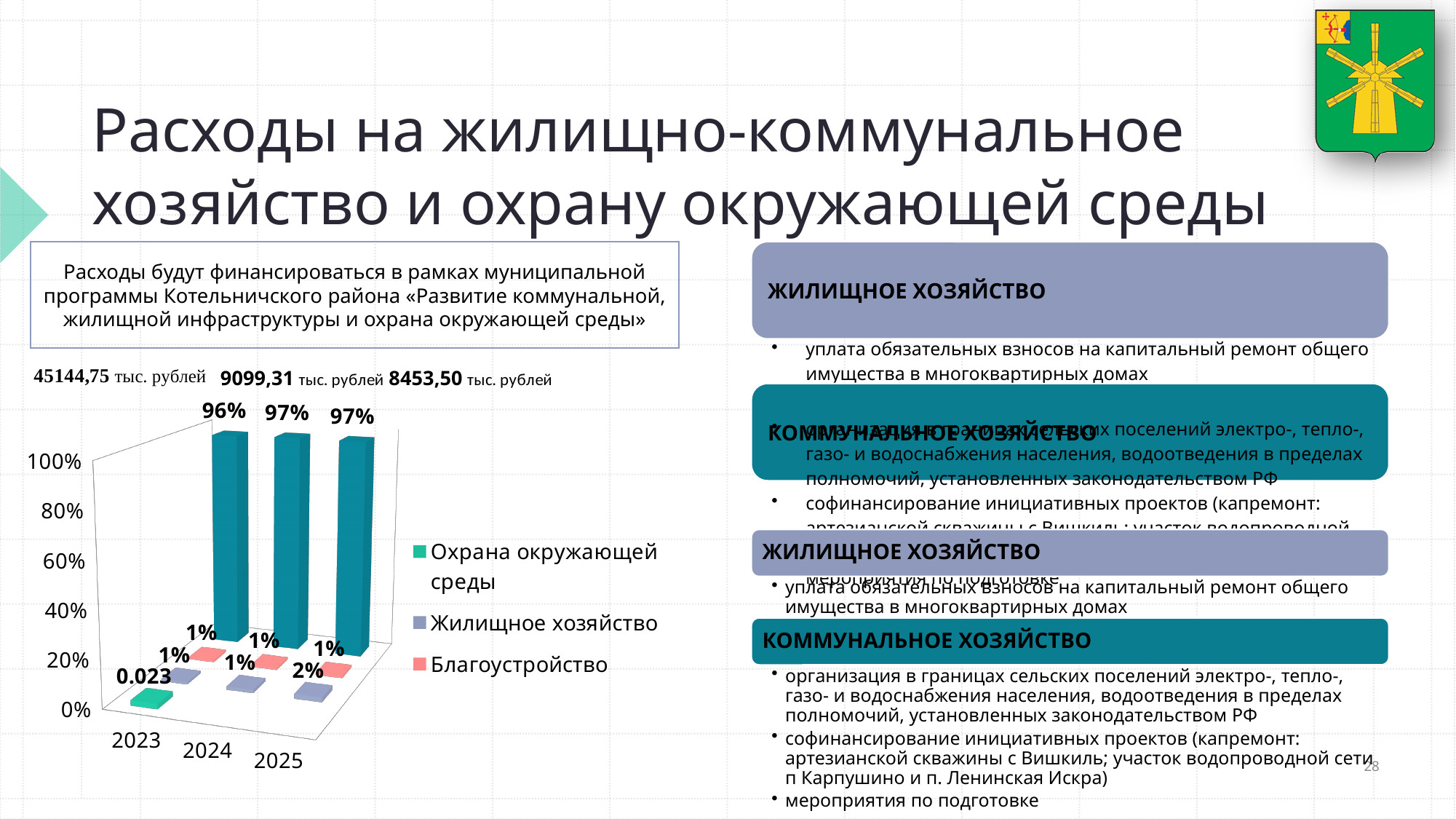
Is the value of the tallest (teal) bar for 2023 greater or less than 80%? greater What colour is used for Благоустройство in the legend? pink How many series does the chart legend list? 3 What kind of chart is shown on the slide? bar chart Which is larger: Жилищное хозяйство in 2024 or in 2025? 2025 What is the value for Благоустройство in 2023? 1% How many years are shown on the x axis of the chart? 3 What is the difference between Жилищное хозяйство in 2025 and in 2024? 1% What is the value for Охрана окружающей среды in 2023? 0.023 What is the data label on the tallest (teal) bar for 2024? 97% What is the value for Жилищное хозяйство in 2025? 2% In which year is the value for Жилищное хозяйство highest? 2025